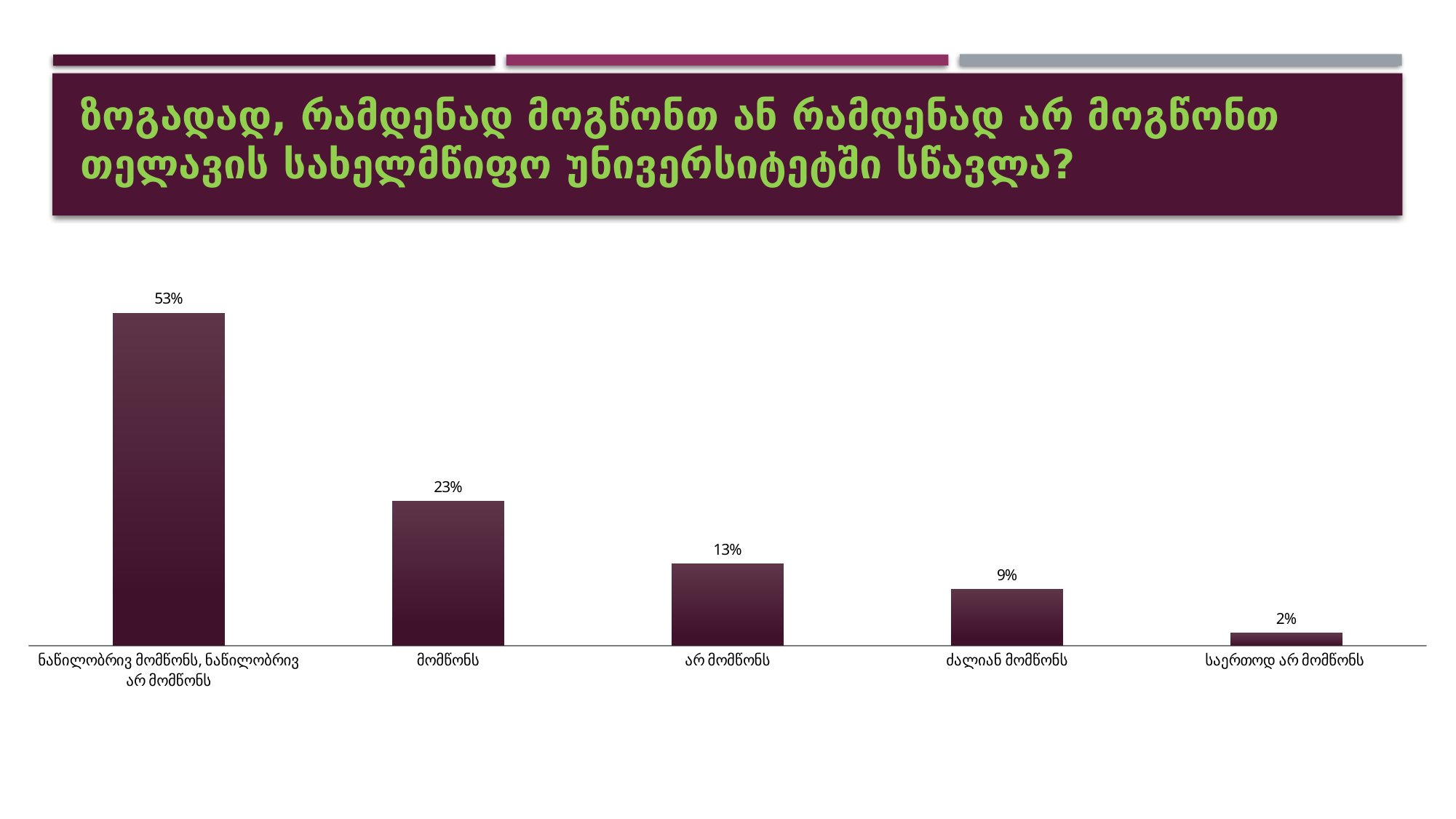
What is the value for "ძალიან მომწონს"? 9% What is the difference between the values for "ნაწილობრივ მომწონს, ნაწილობრივ არ მომწონს" and "მომწონს"? 30% Which category has the highest value? ნაწილობრივ მომწონს, ნაწილობრივ არ მომწონს What is the value for "საერთოდ არ მომწონს"? 2% What is the value for "მომწონს"? 23% What is the difference between the values for "არ მომწონს" and "ძალიან მომწონს"? 4% What is the value for "არ მომწონს"? 13% What kind of chart is shown on the slide? bar chart Which is larger, the value for "მომწონს" or the value for "არ მომწონს"? მომწონს How many categories are shown in the chart? 5 Do the values rise or fall from left to right along the x axis? fall Which category has the lowest value? საერთოდ არ მომწონს